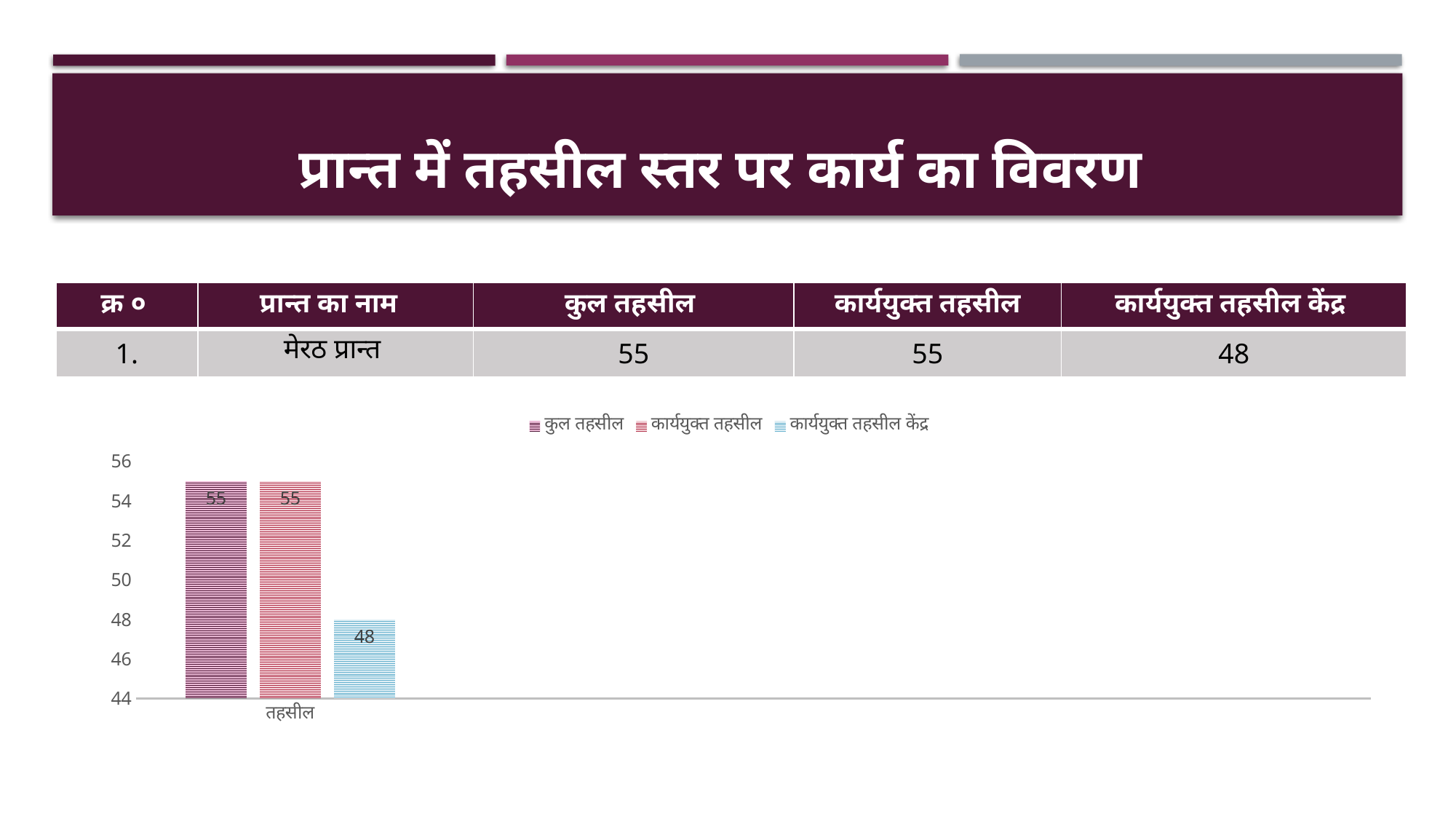
What is the value of the कार्ययुक्त तहसील bar in the chart? 55 How many categories are shown on the x axis of the chart? 1 What is the lowest value shown on the chart's y axis? 44 What is the difference between the कुल तहसील value and the कार्ययुक्त तहसील केंद्र value? 7 What type of chart is shown on the slide? bar chart What is the category label shown on the x axis of the chart? तहसील What is the value of the कार्ययुक्त तहसील केंद्र bar in the chart? 48 How many series does the chart legend list? 3 Is the value for कार्ययुक्त तहसील केंद्र greater or less than 50? less Which is larger in the chart, कार्ययुक्त तहसील or कार्ययुक्त तहसील केंद्र? कार्ययुक्त तहसील Which series has the lowest value in the chart? कार्ययुक्त तहसील केंद्र What is the value of the कुल तहसील bar in the chart? 55